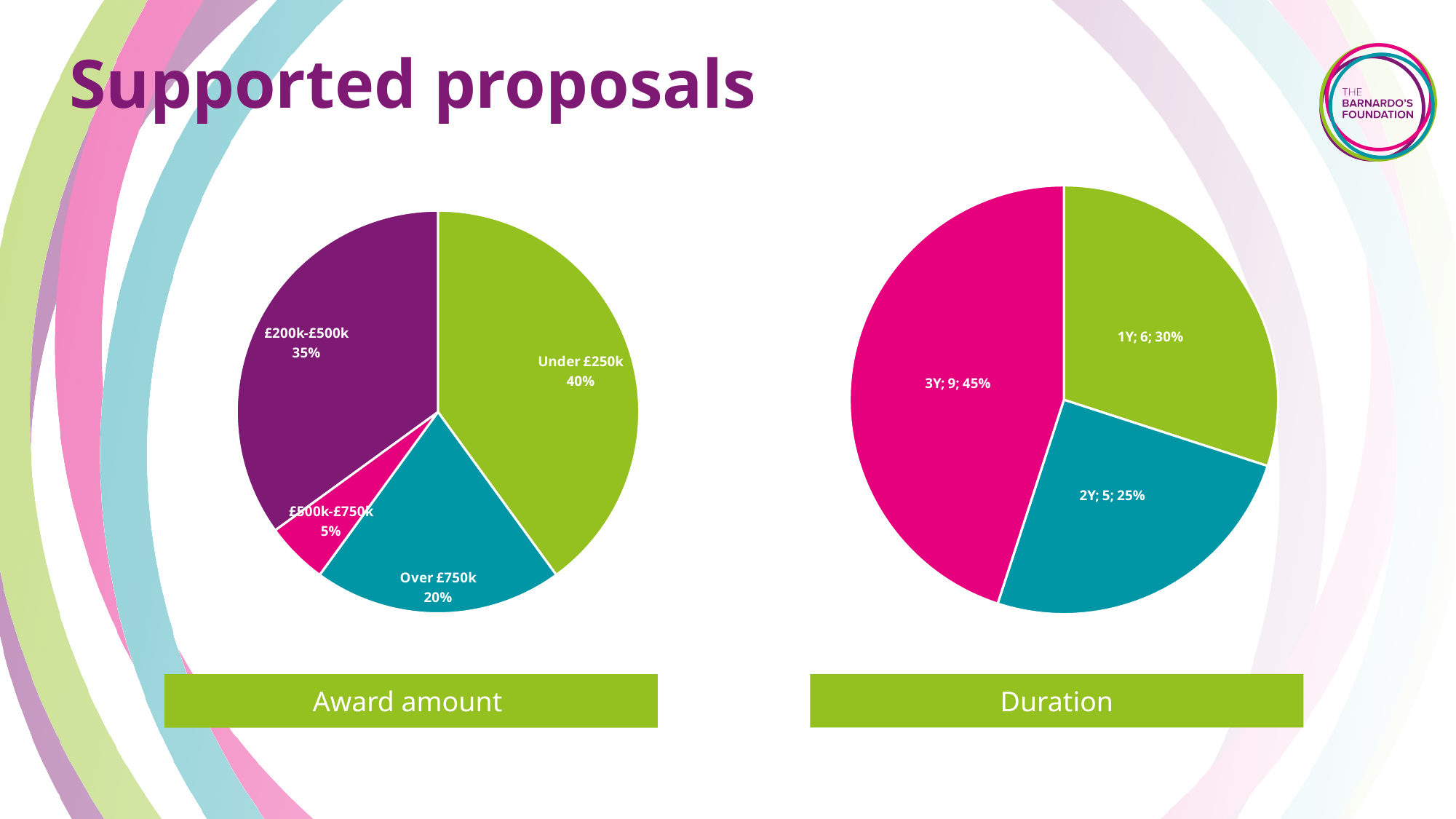
In the Duration pie chart, which duration has the largest share? 3Y In the Award amount pie chart, which award band has the largest share? Under £250k In the Award amount pie chart, how many award bands are shown? 4 What type of chart is used for the Duration chart? Pie chart In the Duration pie chart, what share of proposals had a duration of 2Y? 25% In the Duration pie chart, how many proposals had a duration of 3Y? 9 In the Award amount pie chart, what share of supported proposals were £200k-£500k? 35% In the Award amount pie chart, how many percentage points larger is the Under £250k share than the Over £750k share? 20 In the Award amount pie chart, which award band has the smallest share? £500k-£750k In the Duration pie chart, which is larger: the share for 1Y or the share for 2Y? 1Y In the Duration pie chart, what is the total number of proposals across all durations? 20 In the Award amount pie chart, what share of supported proposals were Under £250k? 40%